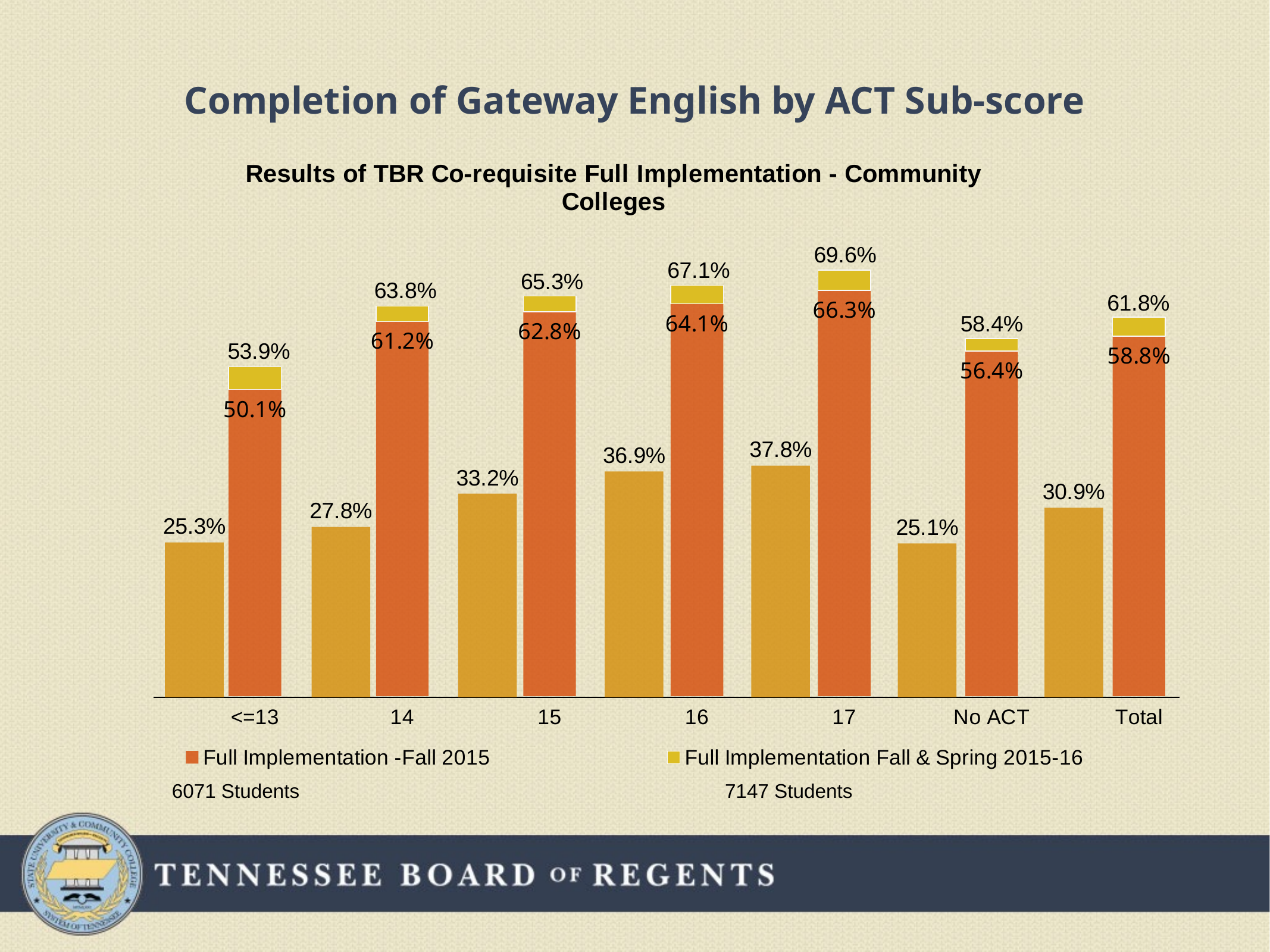
What is the Full Implementation - Fall 2015 completion rate for the No ACT group? 56.4% What is the title of the chart on the slide? Results of TBR Co-requisite Full Implementation - Community Colleges How many series does the chart's legend list? 2 What is the Full Implementation - Fall 2015 completion rate for the ACT sub-score 17 group? 66.3% What type of chart is shown on the slide? Bar chart Which has the higher Full Implementation - Fall 2015 completion rate: the 14 group or the 15 group? 15 How many categories are shown along the x axis of the chart? 7 Which ACT sub-score category has the highest Full Implementation Fall & Spring 2015-16 completion rate? 17 How many students are noted under the Full Implementation - Fall 2015 legend entry? 6071 Students For the ACT sub-score 17 group, how much higher is the Full Implementation Fall & Spring 2015-16 rate than the Full Implementation - Fall 2015 rate? 3.3 percentage points Which ACT sub-score category has the lowest Full Implementation - Fall 2015 completion rate? <=13 What is the Full Implementation Fall & Spring 2015-16 completion rate for the Total group? 61.8%